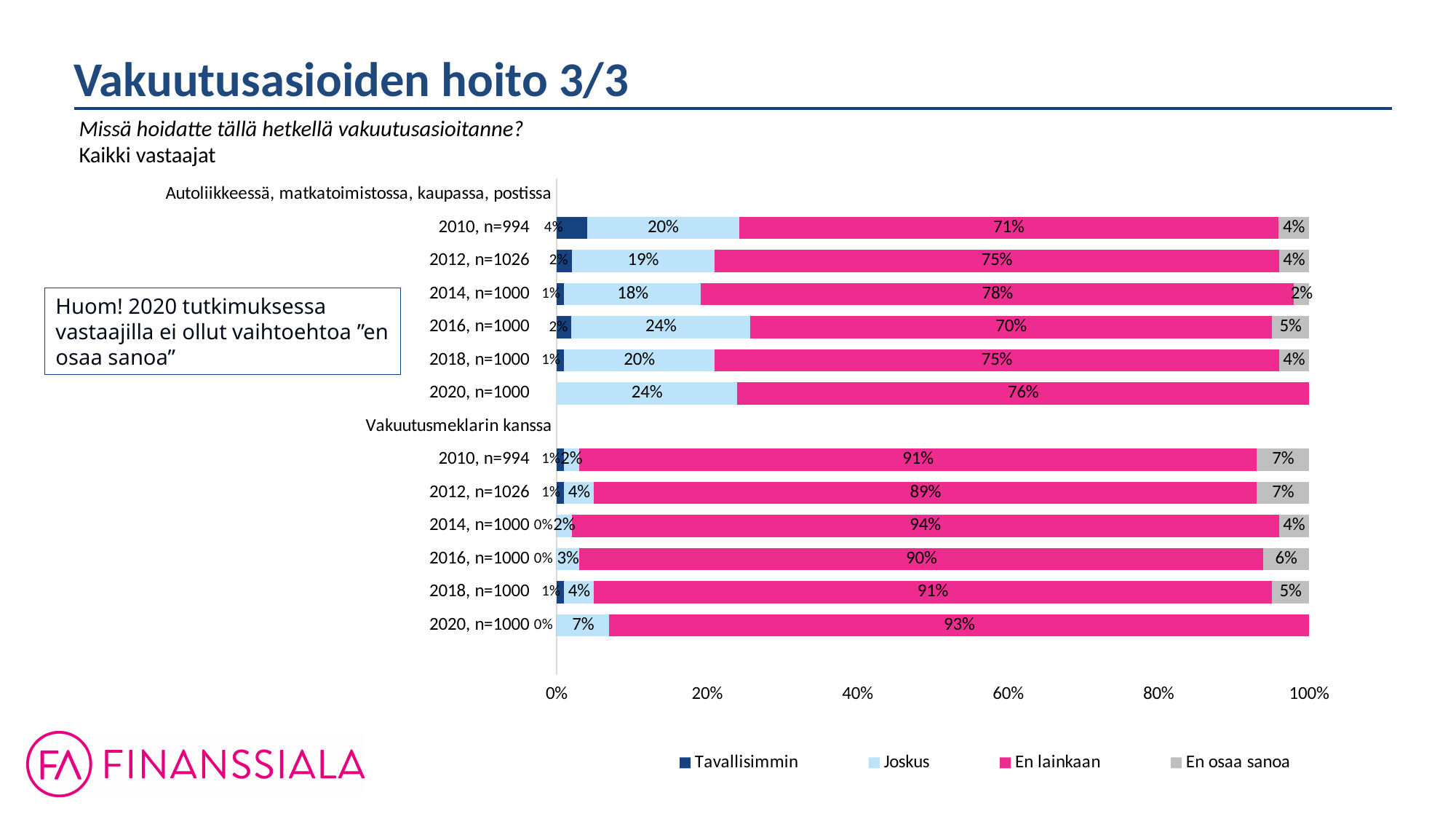
What is the difference between the 'En lainkaan' values for 2014, n=1000 and 2010, n=994 in the 'Autoliikkeessä, matkatoimistossa, kaupassa, postissa' group? 7 percentage points What kind of chart is shown on the slide? Stacked bar chart In the 'Autoliikkeessä, matkatoimistossa, kaupassa, postissa' group, which year has the lowest 'En lainkaan' value? 2016, n=1000 What is the 'Tavallisimmin' value for 2010, n=994 in the 'Autoliikkeessä, matkatoimistossa, kaupassa, postissa' group? 4% Which legend entry is shown in grey? En osaa sanoa What is the 'En osaa sanoa' value for 2012, n=1026 in the 'Vakuutusmeklarin kanssa' group? 7% What is the 'En lainkaan' value for 2014, n=1000 in the 'Autoliikkeessä, matkatoimistossa, kaupassa, postissa' group? 78% Which is larger in the 'Vakuutusmeklarin kanssa' group: the 'En lainkaan' value for 2012, n=1026 or for 2020, n=1000? 2020, n=1000 How many series does the legend list? 4 What is the 'Joskus' value for 2020, n=1000 in the 'Vakuutusmeklarin kanssa' group? 7% How many bars (year rows) are plotted in the chart in total? 12 In the 'Vakuutusmeklarin kanssa' group, which year has the highest 'En lainkaan' value? 2014, n=1000